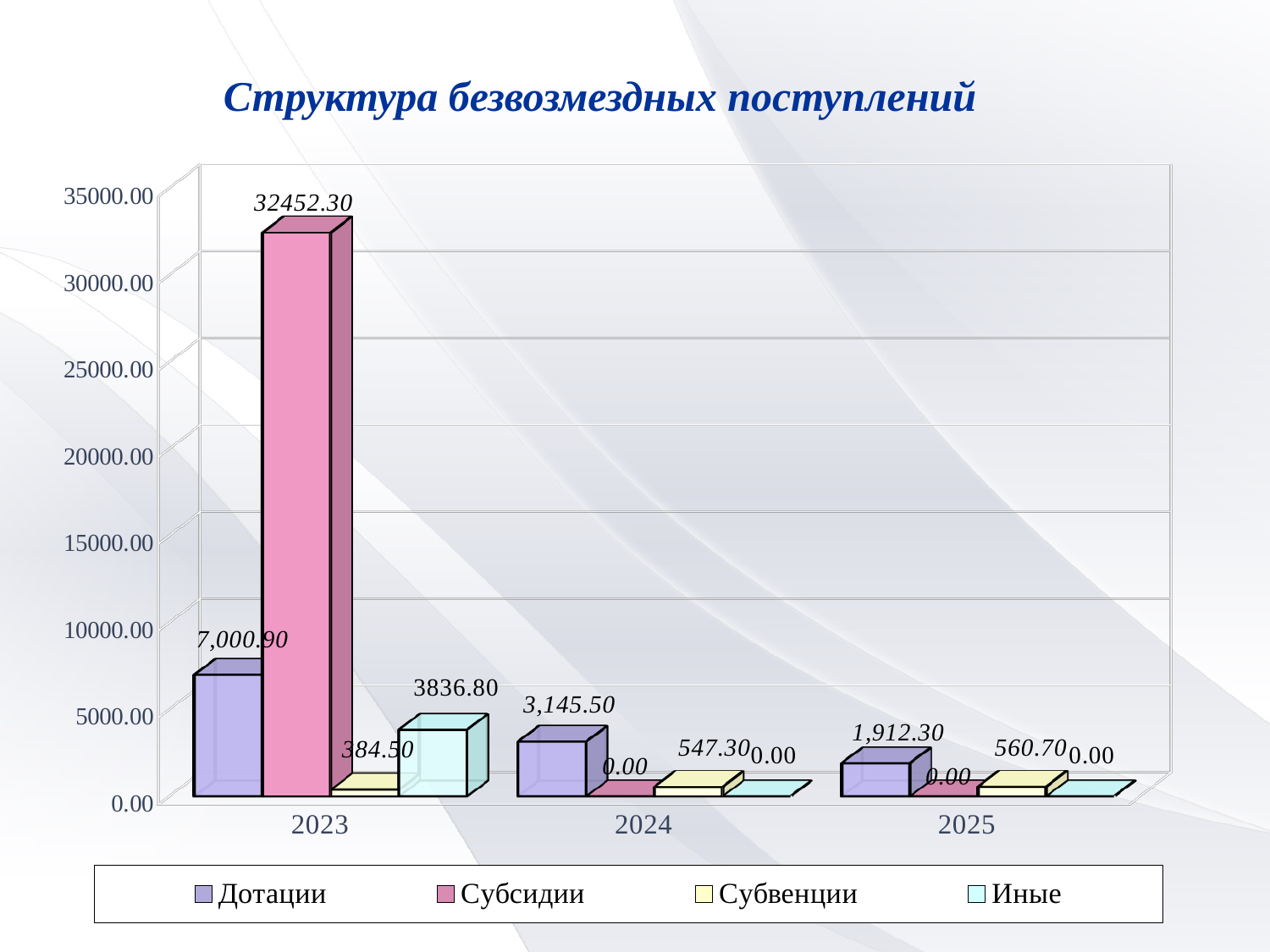
How many years are shown on the x axis? 3 Which is larger: Субвенции in 2024 or Субвенции in 2025? Субвенции in 2025 What is the value for Дотации in 2024? 3,145.50 What kind of chart is shown on the slide? Bar chart What is the value for Субвенции in 2025? 560.70 What is the value for Иные in 2023? 3836.80 Which series has the lowest value in 2023? Субвенции How many series does the legend list? 4 Do the values for Дотации rise or fall from 2023 to 2025? Fall What is the difference between Дотации in 2023 and Дотации in 2025? 5,088.60 What is the value for Субсидии in 2023? 32452.30 Which series has the highest value in 2023? Субсидии